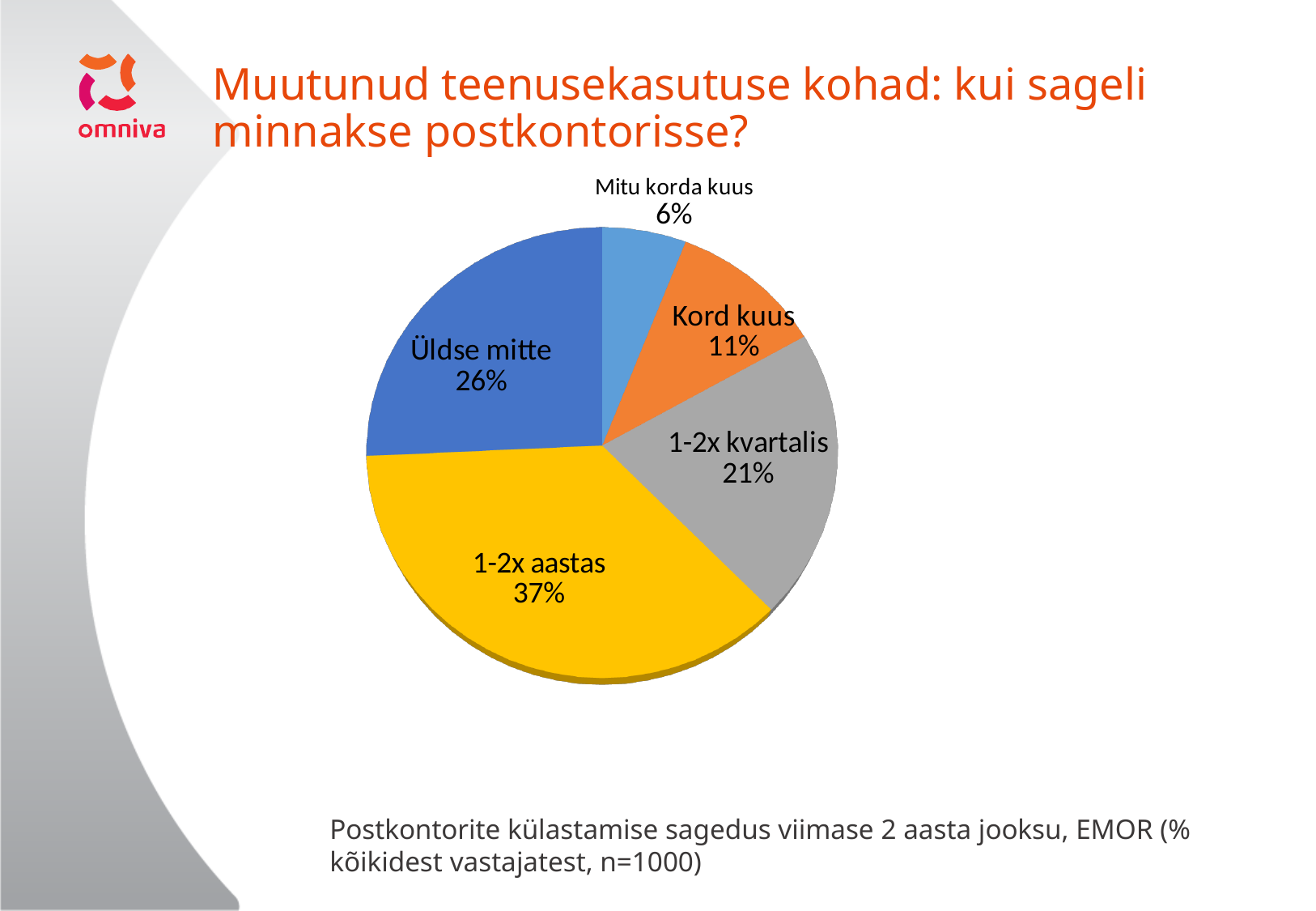
What share of respondents visit the post office 1-2x aastas? 37% What is the value for the 'Üldse mitte' slice? 26% What percentage is shown for the 'Kord kuus' slice? 11% What percentage is shown for 'Mitu korda kuus'? 6% What is the difference between the shares for '1-2x aastas' and 'Üldse mitte'? 11 percentage points Which category has the largest share of the pie? 1-2x aastas Which is larger: the share for '1-2x kvartalis' or for 'Kord kuus'? 1-2x kvartalis What colour is the '1-2x aastas' slice? yellow Which category has the smallest share of the pie? Mitu korda kuus What is the combined share of 'Kord kuus' and 'Mitu korda kuus'? 17% How many slices does the pie chart have? 5 What type of chart is shown on the slide? pie chart